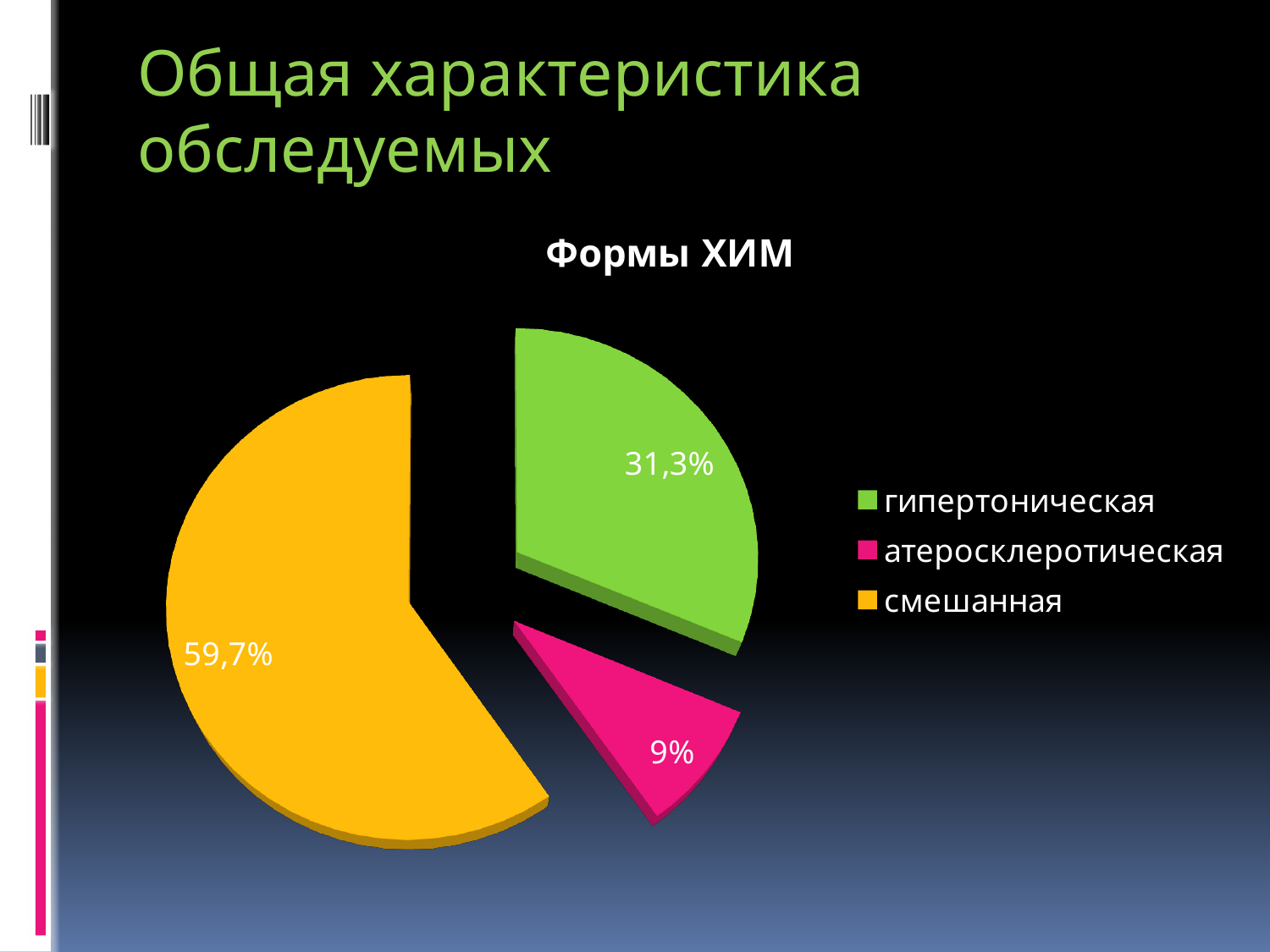
How many categories does the pie chart show? 3 Which category has the smallest slice of the pie? атеросклеротическая What share of the pie does гипертоническая have? 31,3% What share of the pie does смешанная have? 59,7% How many entries does the legend list? 3 What is the title of the chart? Формы ХИМ Which is larger, the slice for гипертоническая or the slice for атеросклеротическая? гипертоническая Which category has the largest slice of the pie? смешанная What type of chart is shown on the slide? pie chart What share of the pie does атеросклеротическая have? 9% What is the difference in percentage points between the смешанная slice and the гипертоническая slice? 28,4 What colour is the slice for смешанная? yellow